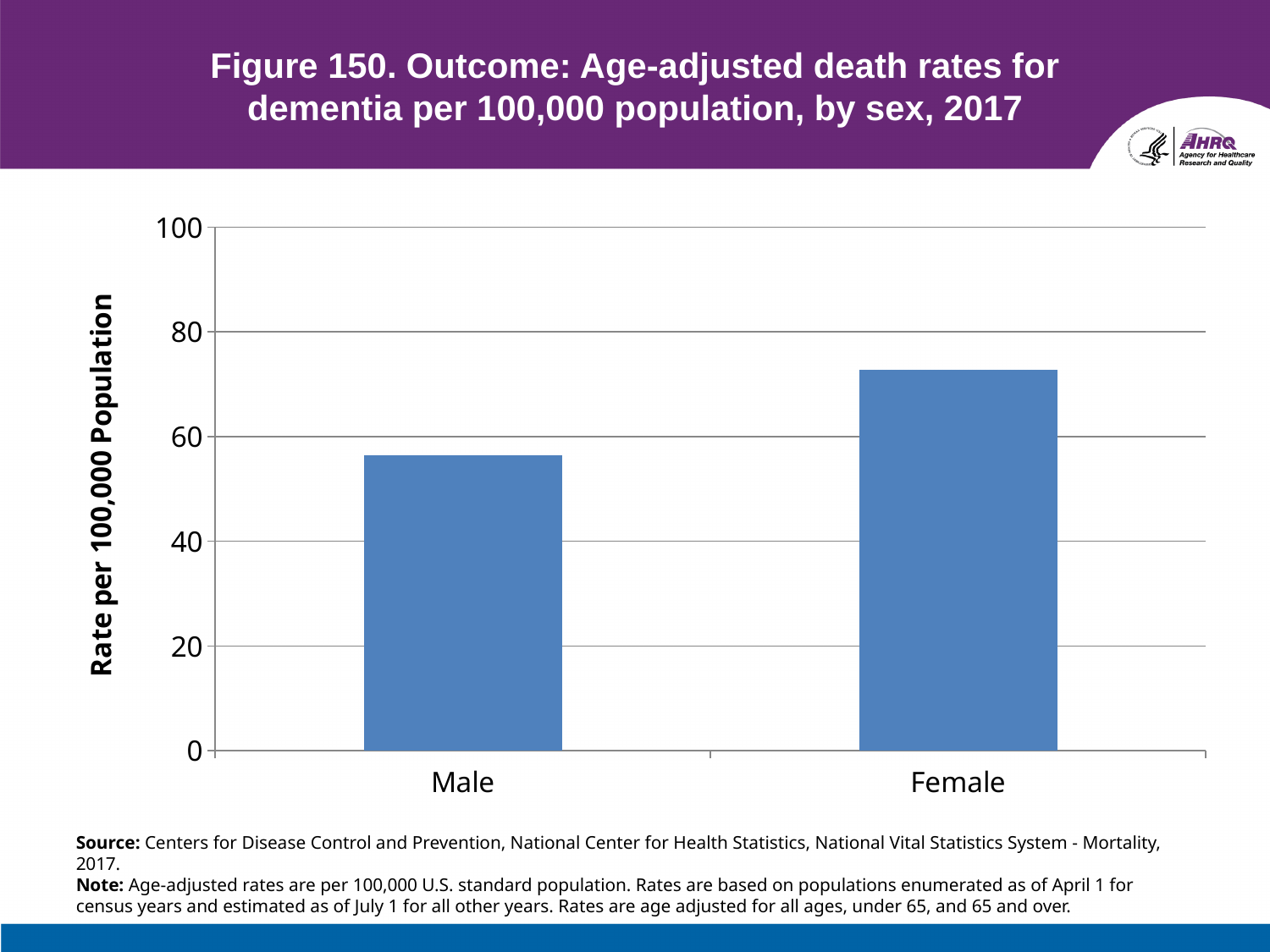
Is the value for Female greater or less than 80? less Which is larger, the death rate for Male or for Female? Female Is the value for Male greater or less than 40? greater What year does the chart's data refer to, according to the title? 2017 Which category has the highest age-adjusted death rate for dementia? Female Is the value for Male greater or less than 60? less How many categories are plotted on the x axis? 2 What is the title of the y axis? Rate per 100,000 Population Which category has the lowest age-adjusted death rate for dementia? Male What kind of chart is shown on the slide? bar chart